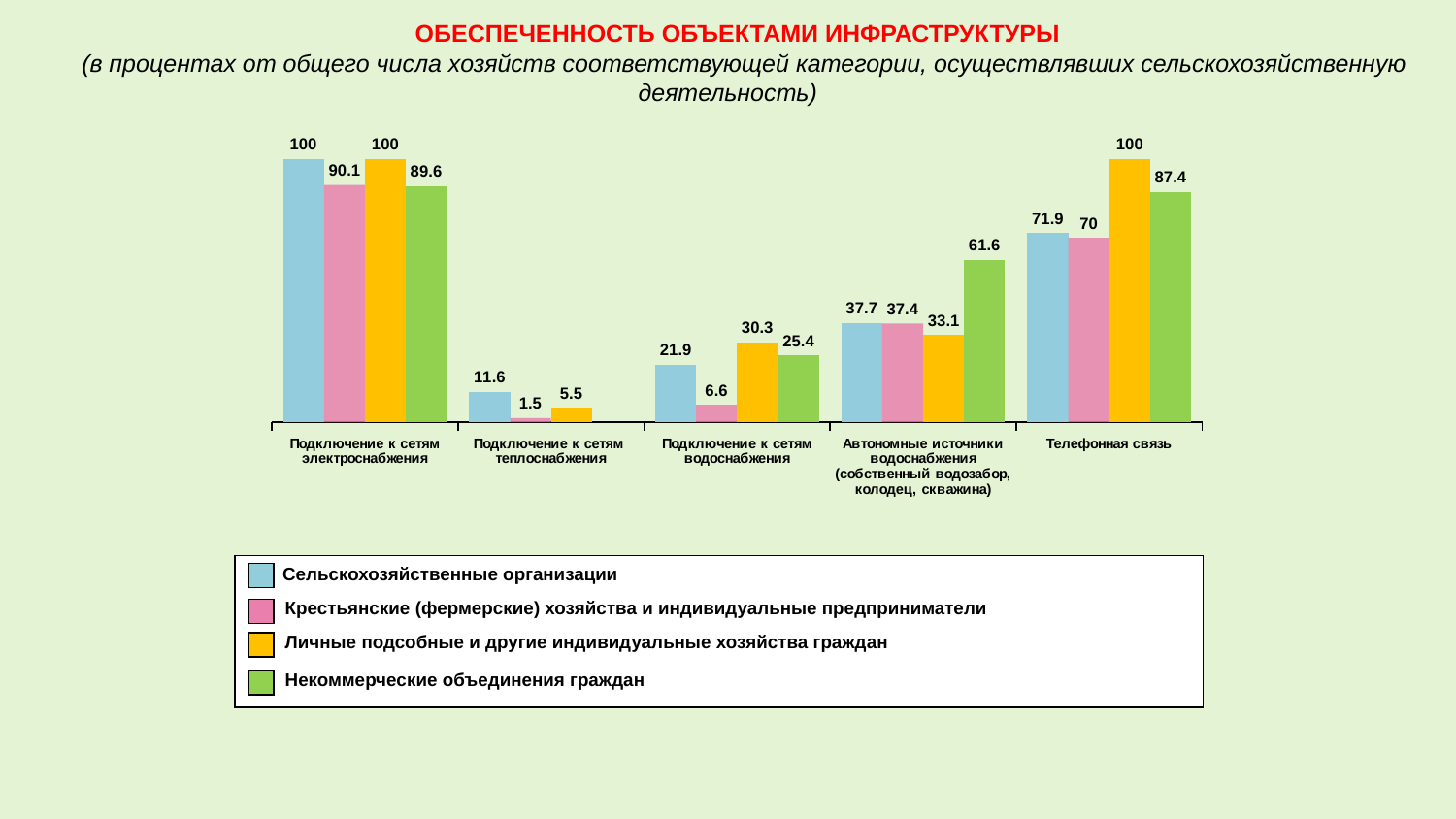
What is the title of the chart? ОБЕСПЕЧЕННОСТЬ ОБЪЕКТАМИ ИНФРАСТРУКТУРЫ How many categories are shown on the x axis? 5 What is the value for Личные подсобные и другие индивидуальные хозяйства граждан in the category Подключение к сетям водоснабжения? 30.3 What is the value for Сельскохозяйственные организации in the category Подключение к сетям теплоснабжения? 11.6 What type of chart is shown on the slide? Bar chart What is the value for Крестьянские (фермерские) хозяйства и индивидуальные предприниматели in the category Телефонная связь? 70 What is the difference between the values for Сельскохозяйственные организации and Крестьянские (фермерские) хозяйства и индивидуальные предприниматели in the category Подключение к сетям теплоснабжения? 10.1 Which series has the highest value in the category Автономные источники водоснабжения (собственный водозабор, колодец, скважина)? Некоммерческие объединения граждан In the category Телефонная связь, which is larger: the value for Личные подсобные и другие индивидуальные хозяйства граждан or the value for Некоммерческие объединения граждан? Личные подсобные и другие индивидуальные хозяйства граждан What is the value for Некоммерческие объединения граждан in the category Автономные источники водоснабжения (собственный водозабор, колодец, скважина)? 61.6 Which series has the lowest value in the category Подключение к сетям водоснабжения? Крестьянские (фермерские) хозяйства и индивидуальные предприниматели How many series does the legend list? 4